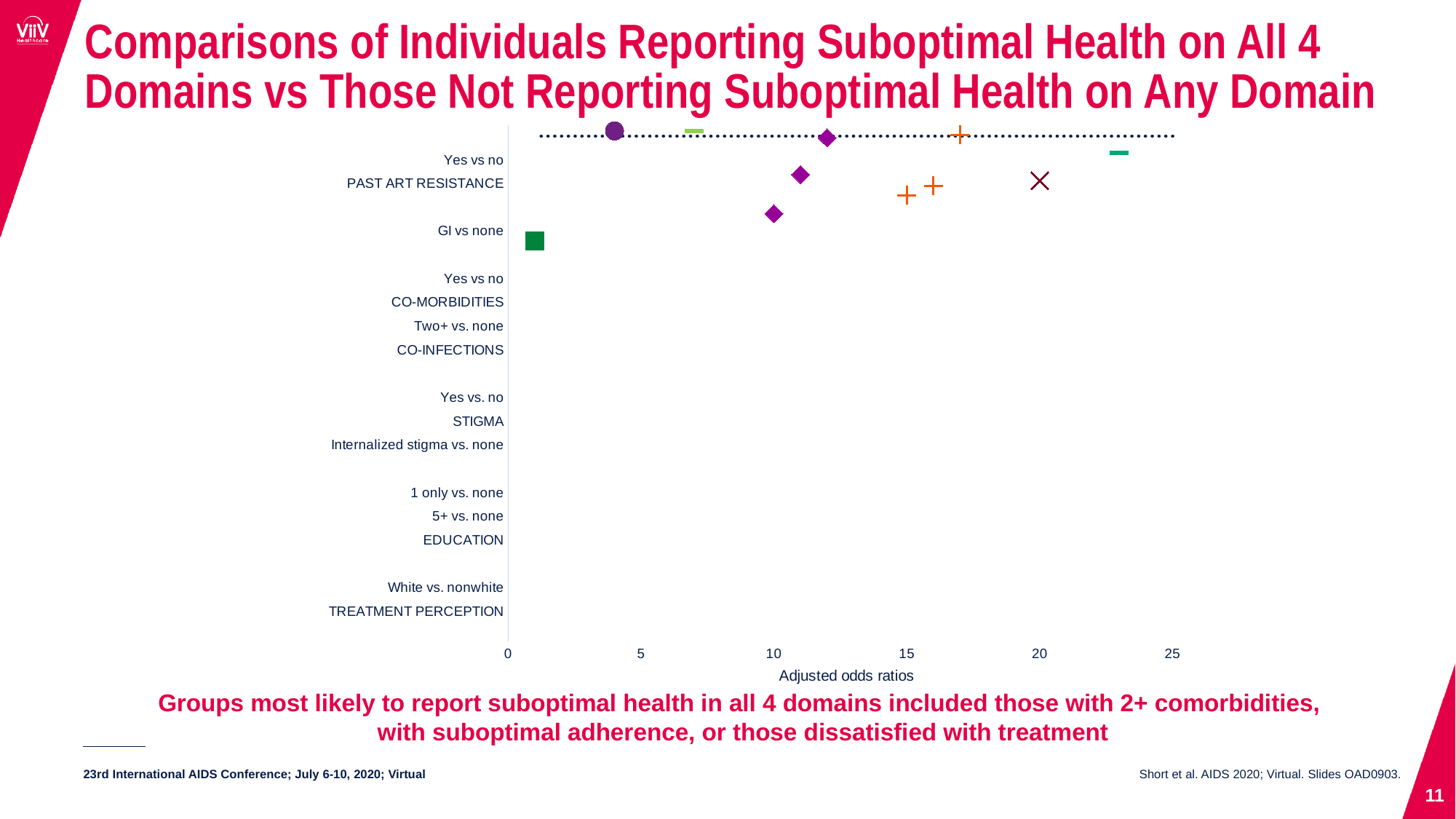
What is the title of the horizontal axis of the chart? Adjusted odds ratios Is the largest plotted adjusted odds ratio on the chart greater or less than 20? greater What kind of chart is shown on the slide? Scatter (dot) chart Is the value marked by the red X on the chart greater or less than 15? greater Which is larger: the value marked by the red X or the value marked by the green square? The red X How many category labels are listed along the vertical axis of the chart? 15 What is the highest tick value shown on the horizontal axis? 25 Is the value marked by the green square on the chart greater or less than 5? less